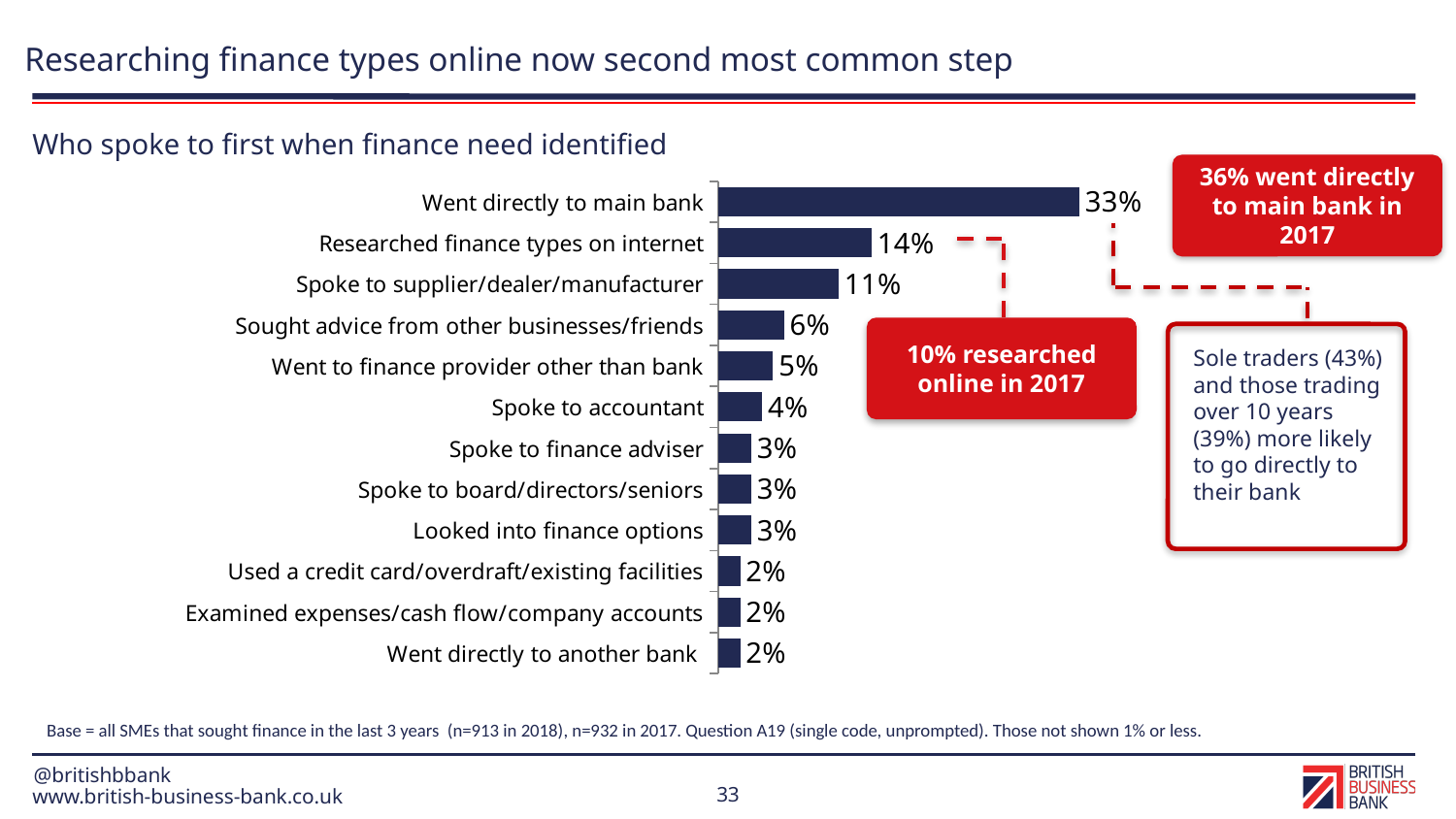
According to the callout, what percentage went directly to their main bank in 2017? 36% What is the difference between 'Sought advice from other businesses/friends' and 'Spoke to accountant'? 2 percentage points What type of chart is shown on the slide? Bar chart What is the value for 'Spoke to supplier/dealer/manufacturer'? 11% How many categories are shown in the chart? 12 What is the value for 'Went to finance provider other than bank'? 5% What is the difference between 'Went directly to main bank' and 'Researched finance types on internet'? 19 percentage points According to the callout, what percentage researched online in 2017? 10% Which is larger: 'Spoke to supplier/dealer/manufacturer' or 'Sought advice from other businesses/friends'? Spoke to supplier/dealer/manufacturer What percentage went directly to their main bank first when a finance need was identified? 33% What percentage researched finance types on the internet first? 14% Which category has the highest value in the chart? Went directly to main bank